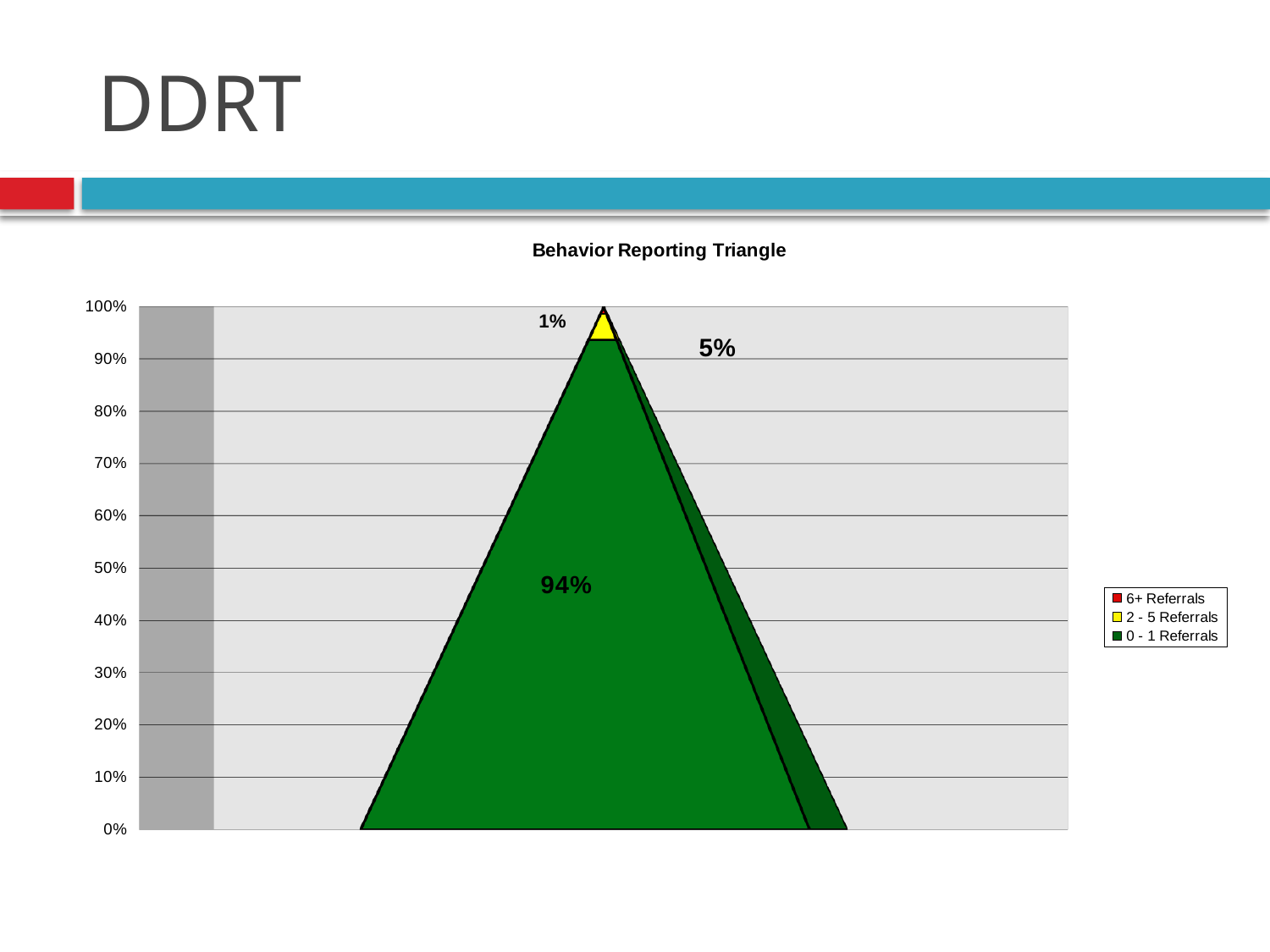
How many series does the legend list? 3 What is the smallest percentage label shown on the chart? 1% Is the value for 0 - 1 Referrals greater or less than 90%? greater What is the highest value shown on the vertical axis? 100% Which referral category has the largest share of the triangle? 0 - 1 Referrals What percentage is shown for 2 - 5 Referrals? 5% What do the three percentage labels on the chart add up to? 100% What is the difference between the 94% and 5% labels on the chart? 89 percentage points What percentage is shown for 0 - 1 Referrals? 94% What is the title of the chart? Behavior Reporting Triangle What is the largest percentage label shown on the chart? 94% Which colour represents 2 - 5 Referrals in the legend? Yellow